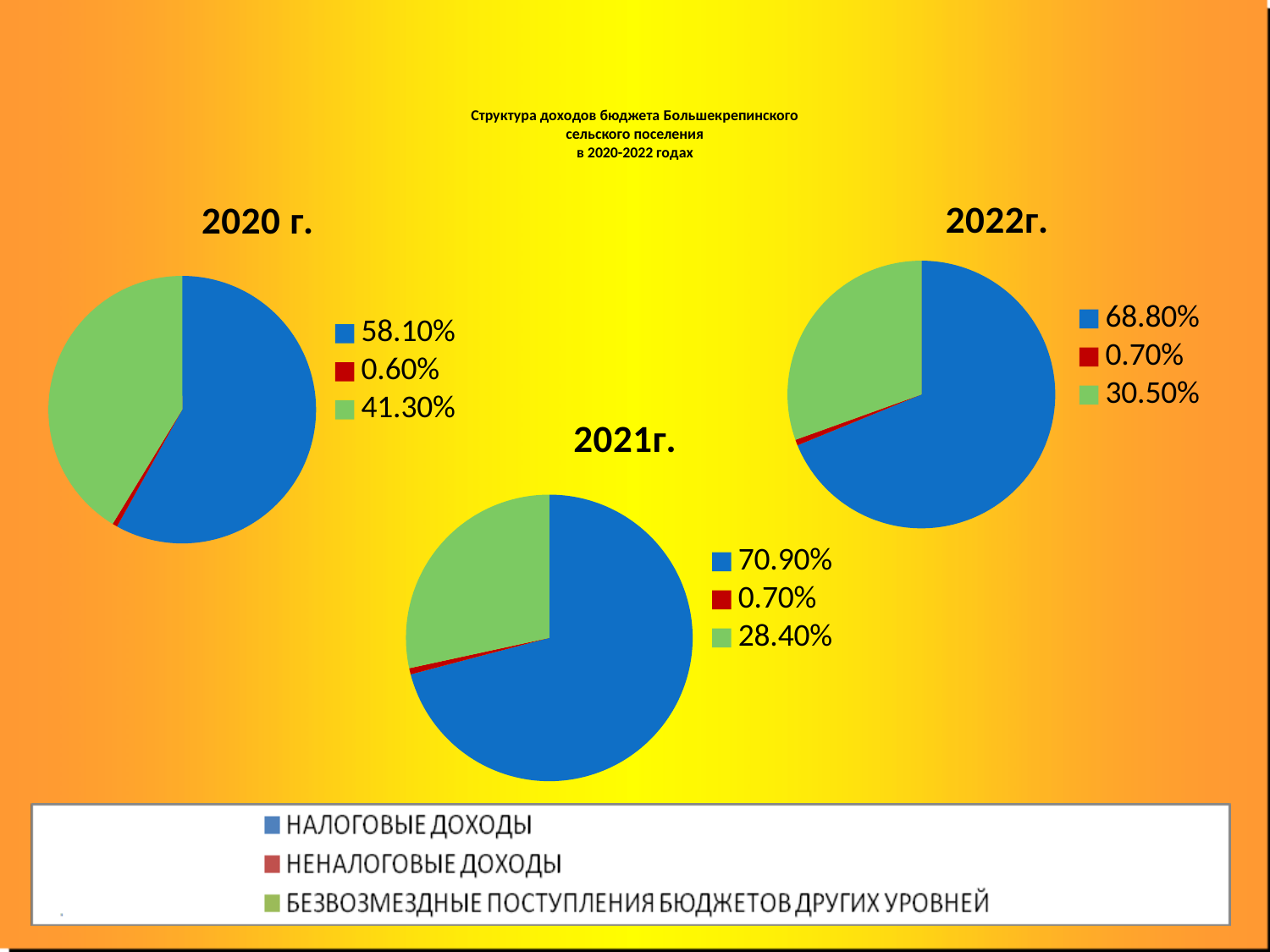
In the 2020 г. pie chart, what share is shown for НАЛОГОВЫЕ ДОХОДЫ (blue)? 58.10% In the 2021г. pie chart, what share is shown for НЕНАЛОГОВЫЕ ДОХОДЫ (red)? 0.70% What kind of chart is used for the 2020 г. data on the slide? Pie chart In the 2020 г. pie chart, what share is shown for БЕЗВОЗМЕЗДНЫЕ ПОСТУПЛЕНИЯ БЮДЖЕТОВ ДРУГИХ УРОВНЕЙ (green)? 41.30% How many categories does the legend at the bottom of the slide list? 3 Which year's pie chart shows a larger share for НАЛОГОВЫЕ ДОХОДЫ: 2020 г. or 2022г.? 2022г. How many pie charts are shown on the slide? 3 In the 2022г. pie chart, which category has the largest share? НАЛОГОВЫЕ ДОХОДЫ In the 2022г. pie chart, what share is shown for БЕЗВОЗМЕЗДНЫЕ ПОСТУПЛЕНИЯ БЮДЖЕТОВ ДРУГИХ УРОВНЕЙ (green)? 30.50% In the 2021г. pie chart, what is the difference between the blue share (70.90%) and the green share (28.40%)? 42.50% In the 2020 г. pie chart, which category has the smallest share? НЕНАЛОГОВЫЕ ДОХОДЫ In the 2021г. pie chart, what share is shown for НАЛОГОВЫЕ ДОХОДЫ (blue)? 70.90%